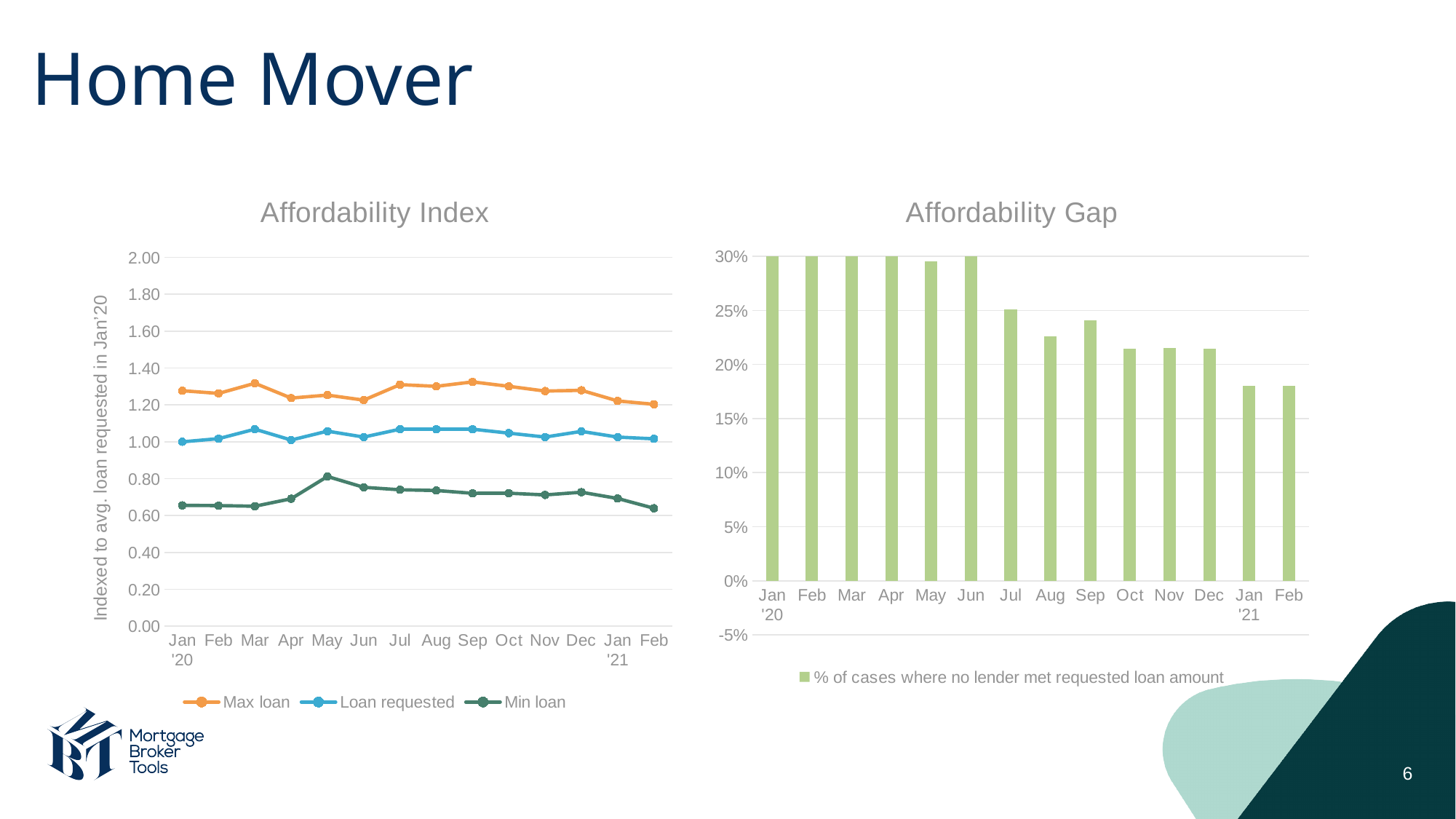
How many bars are plotted in the Affordability Gap chart? 14 In the Affordability Index chart, which series has the lowest values throughout the period? Min loan How many series does the legend of the Affordability Index chart list? 3 In the Affordability Gap chart, is the value for Jul greater or less than 20%? greater In the Affordability Gap chart, is the value for Feb '21 greater or less than 20%? less In the Affordability Index chart, is the Min loan value for May greater or less than 1.00? less In the Affordability Index chart, what is the value of Loan requested in Jan '20? 1.00 In the Affordability Gap chart, do the values generally rise or fall from Jan '20 to Feb '21? fall What kind of chart is the Affordability Gap chart? bar chart What kind of chart is the Affordability Index chart? line chart In the Affordability Gap chart, which is larger, the value for Aug or the value for Sep? Sep